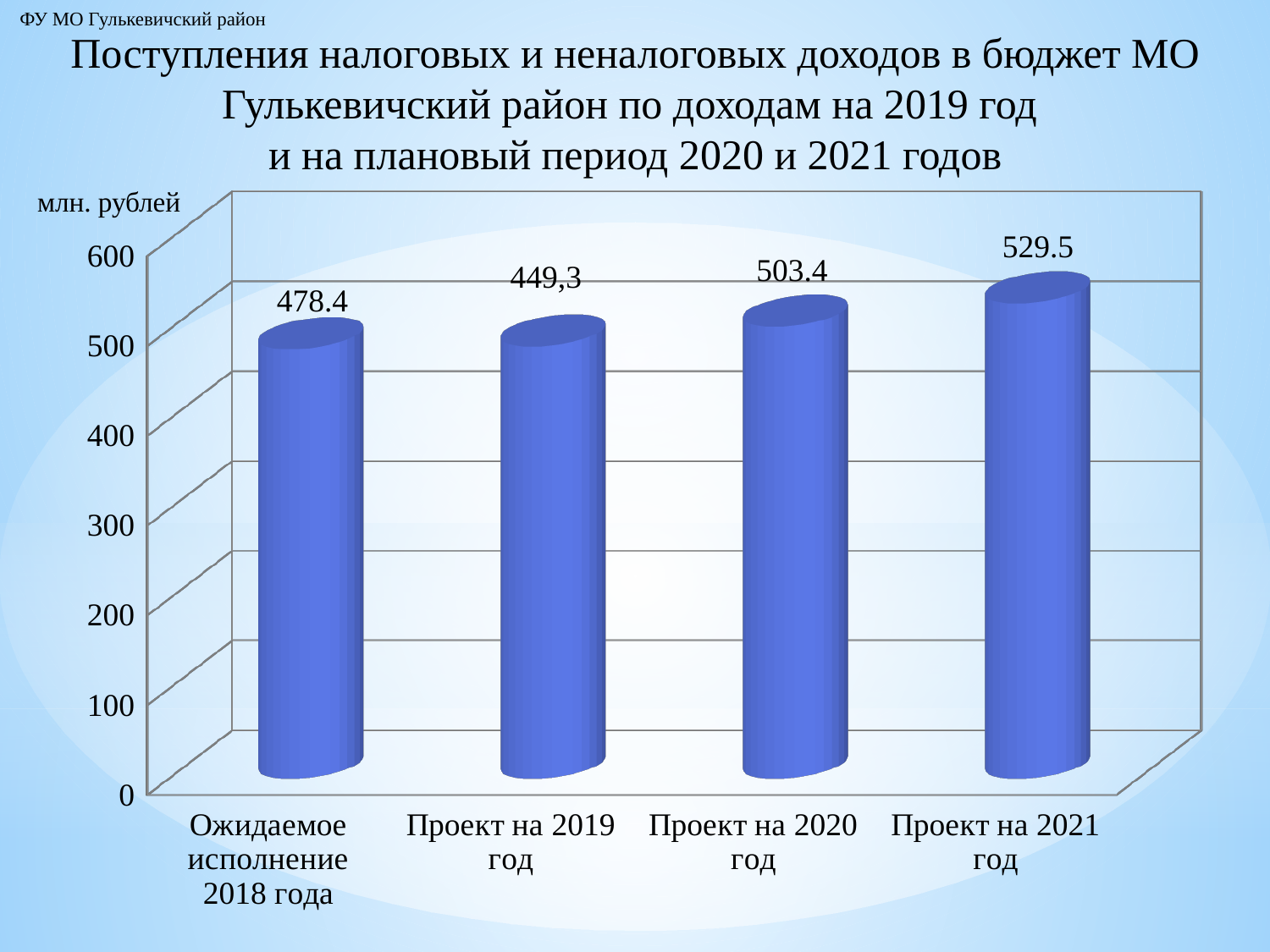
What kind of chart is shown on the slide? bar chart What is the value for "Проект на 2020 год"? 503.4 Which category has the highest value? Проект на 2021 год Which is larger: the value for "Проект на 2020 год" or for "Ожидаемое исполнение 2018 года"? Проект на 2020 год What is the difference between the values for "Проект на 2021 год" and "Ожидаемое исполнение 2018 года"? 51.1 What is the value for "Проект на 2019 год"? 449,3 What is the value for "Проект на 2021 год"? 529.5 Is the value for "Проект на 2019 год" greater or less than 500? less What is the value for "Ожидаемое исполнение 2018 года"? 478.4 What is the difference between the values for "Проект на 2021 год" and "Проект на 2020 год"? 26.1 How many categories are shown on the x axis? 4